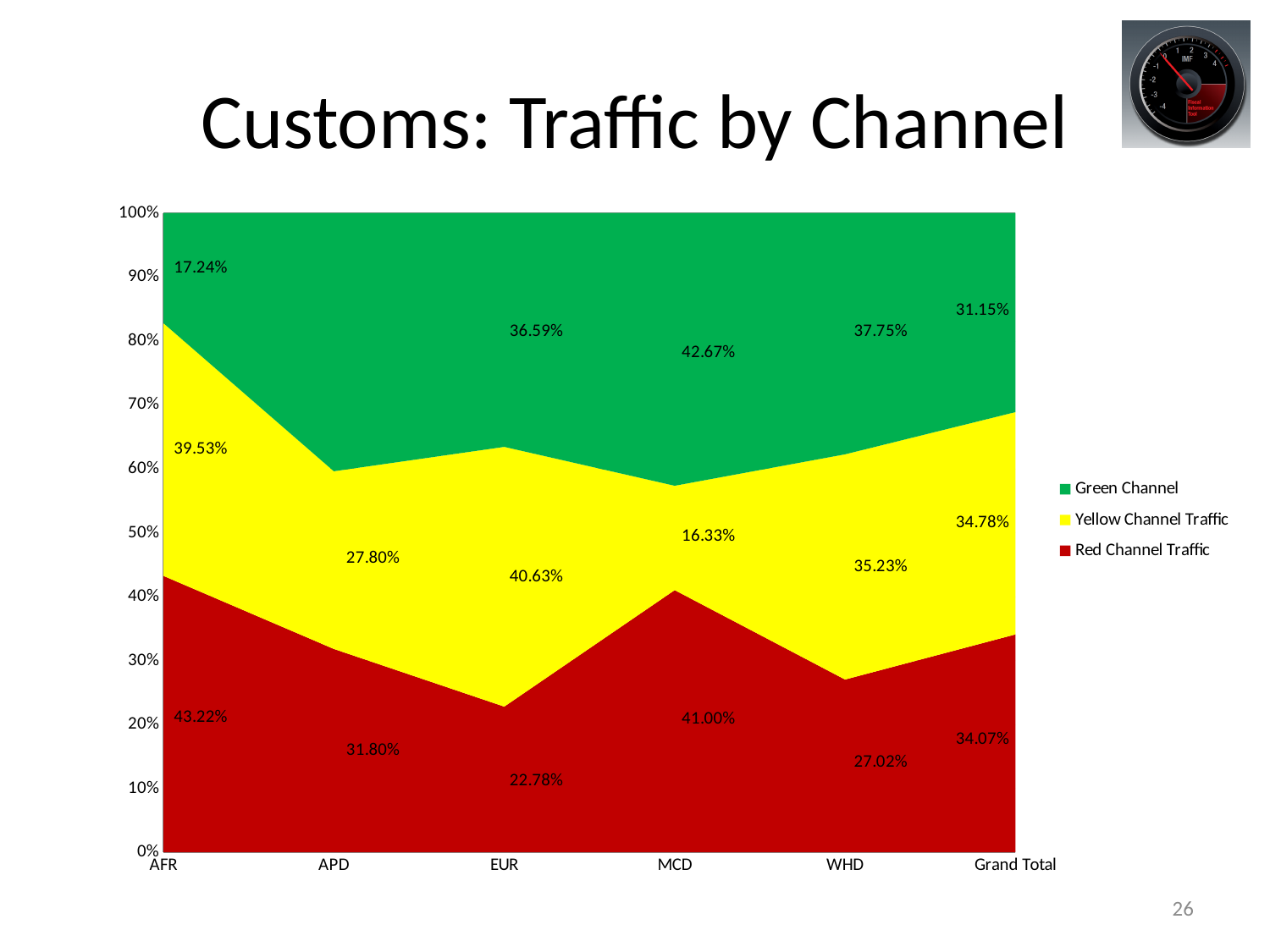
Which category has the lowest Yellow Channel Traffic value? MCD How many categories are shown on the x axis? 6 What is the Green Channel value for MCD? 42.67% What is the Red Channel Traffic value for AFR? 43.22% What kind of chart is shown on the slide? Stacked area chart What is the Yellow Channel Traffic value for EUR? 40.63% What is the Green Channel value for Grand Total? 31.15% Does the Red Channel Traffic value rise or fall from AFR to EUR? Fall Which category has the highest Red Channel Traffic value? AFR How many series does the legend list? 3 What is the difference between the Green Channel values for EUR and AFR? 19.35 percentage points Which has the larger Red Channel Traffic value, WHD or EUR? WHD